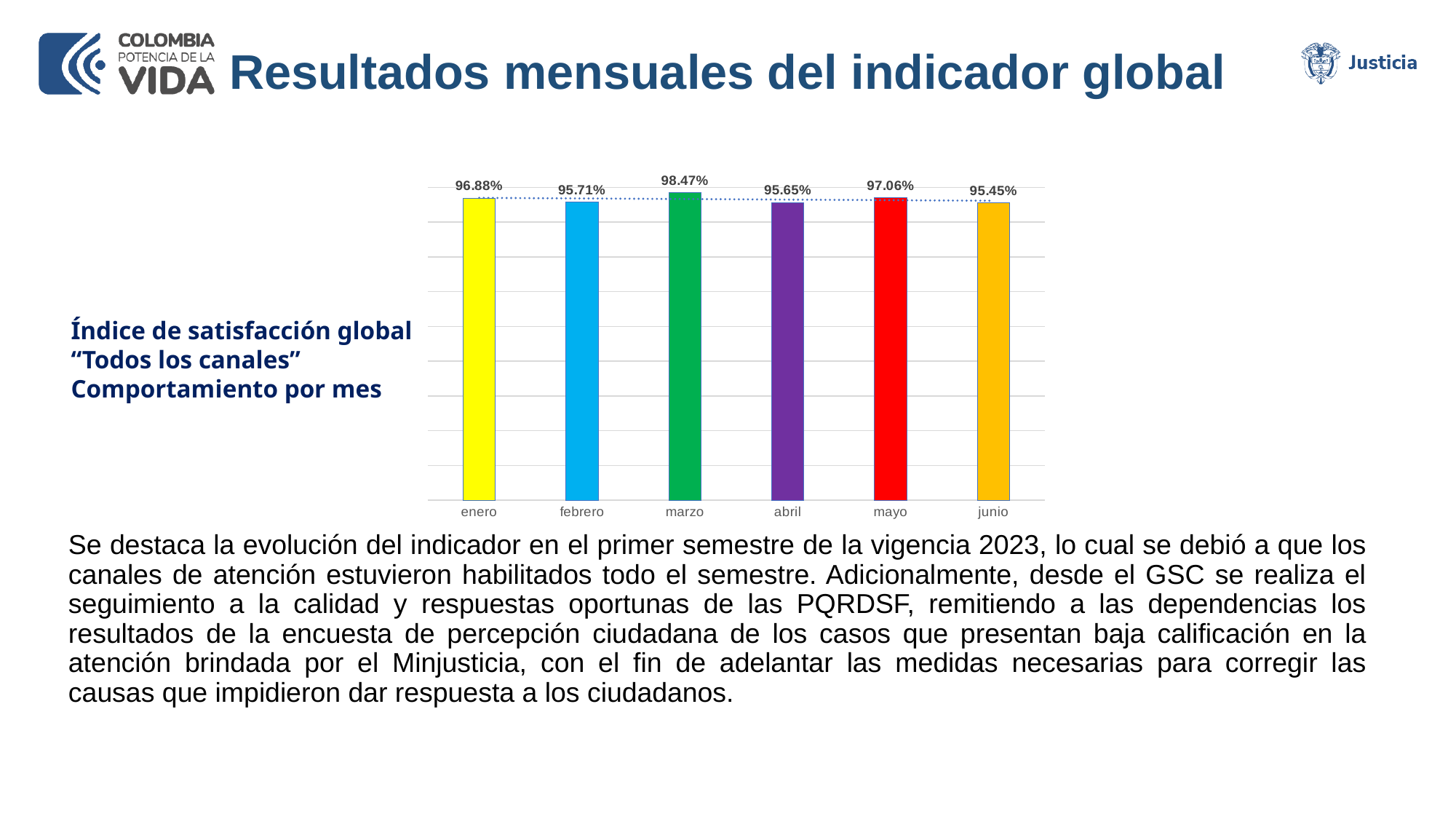
Which month has the highest value? marzo What is the difference between the values for marzo and junio? 3.02% How many months are shown on the x axis? 6 What is the value for mayo? 97.06% What is the value for enero? 96.88% What is the value for junio? 95.45% What is the difference between the values for enero and febrero? 1.17% Which is larger, the value for mayo or the value for abril? mayo What is the value for marzo? 98.47% Which month has the lowest value? junio What colour is the bar for marzo? green What kind of chart is shown? bar chart